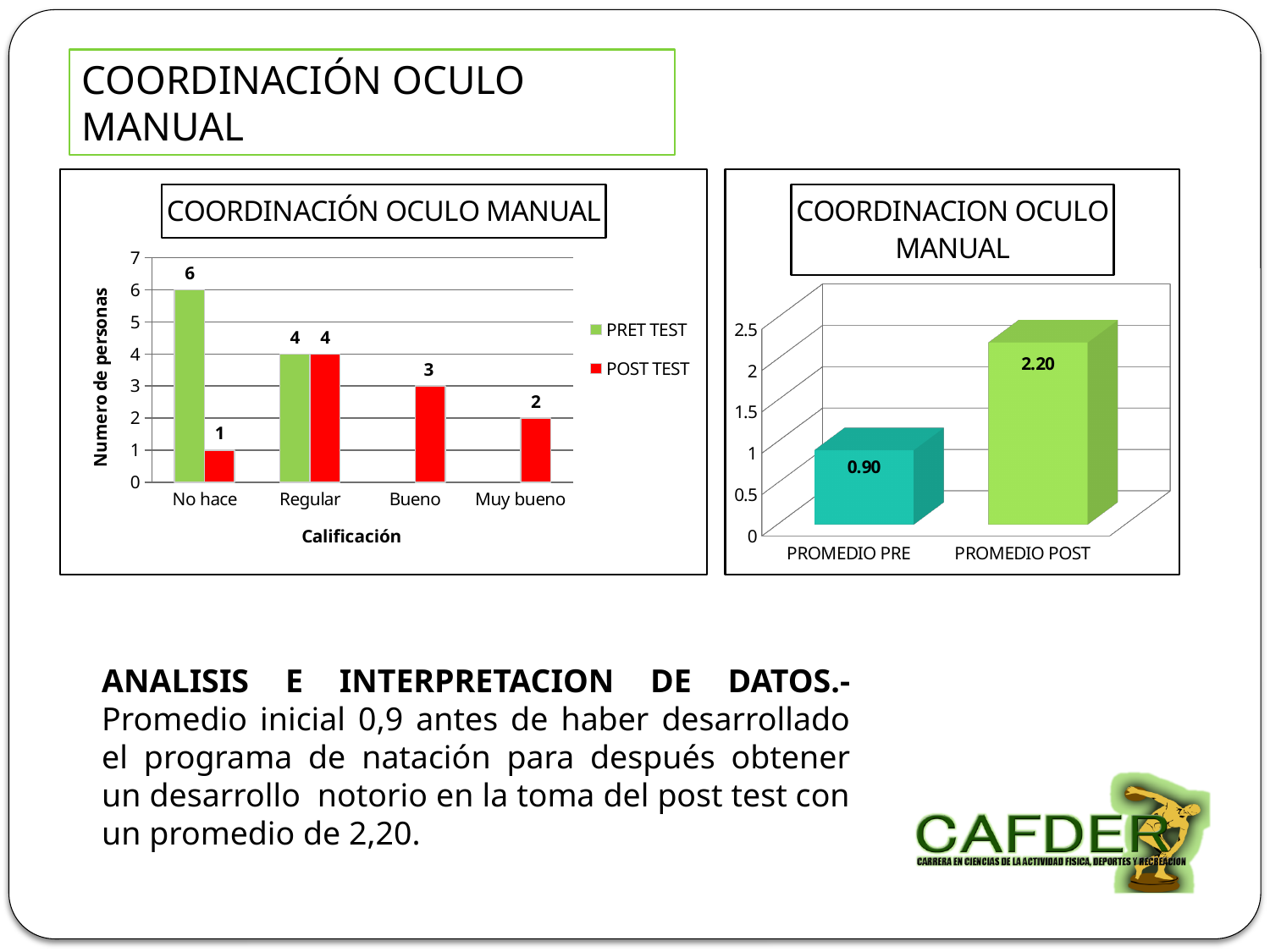
In the right chart, what is the value for PROMEDIO POST? 2.20 In the left chart, which category has the lowest POST TEST value? No hace In the left chart, what is the POST TEST value for Bueno? 3 In the right chart, what is the difference between PROMEDIO POST and PROMEDIO PRE? 1.30 In the left chart, which category has the highest PRET TEST value? No hace What kind of chart is the right chart? Bar chart In the left chart, what is the difference between the PRET TEST and POST TEST values for No hace? 5 In the left chart, what is the POST TEST value for Muy bueno? 2 In the left chart, how many series does the legend list? 2 In the left chart, how many categories are shown on the x axis? 4 In the right chart, what is the value for PROMEDIO PRE? 0.90 In the left chart, what is the PRET TEST value for No hace? 6